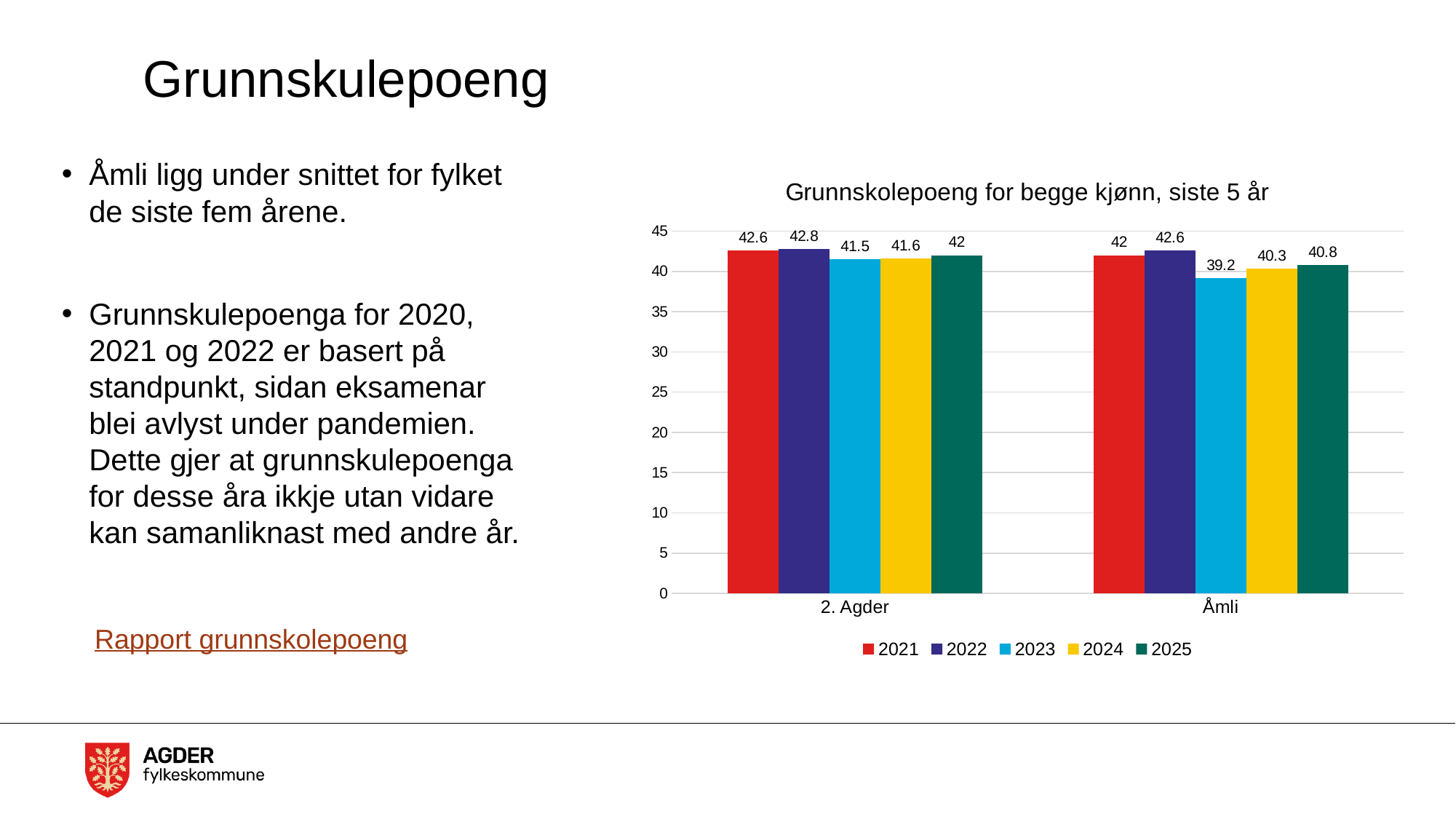
Which year has the highest value for 2. Agder? 2022 What is the value for 2. Agder in 2023? 41.5 What is the value for Åmli in 2025? 40.8 How many categories are shown on the x axis? 2 What is the title of the chart? Grunnskolepoeng for begge kjønn, siste 5 år What is the value for Åmli in 2023? 39.2 Which is larger, the 2022 value for 2. Agder or the 2022 value for Åmli? 2. Agder Which year has the lowest value for Åmli? 2023 Is the value for Åmli in 2023 greater or less than 40? less What is the difference between the 2. Agder and Åmli values in 2023? 2.3 How many series does the legend list? 5 What kind of chart is shown on the slide? bar chart